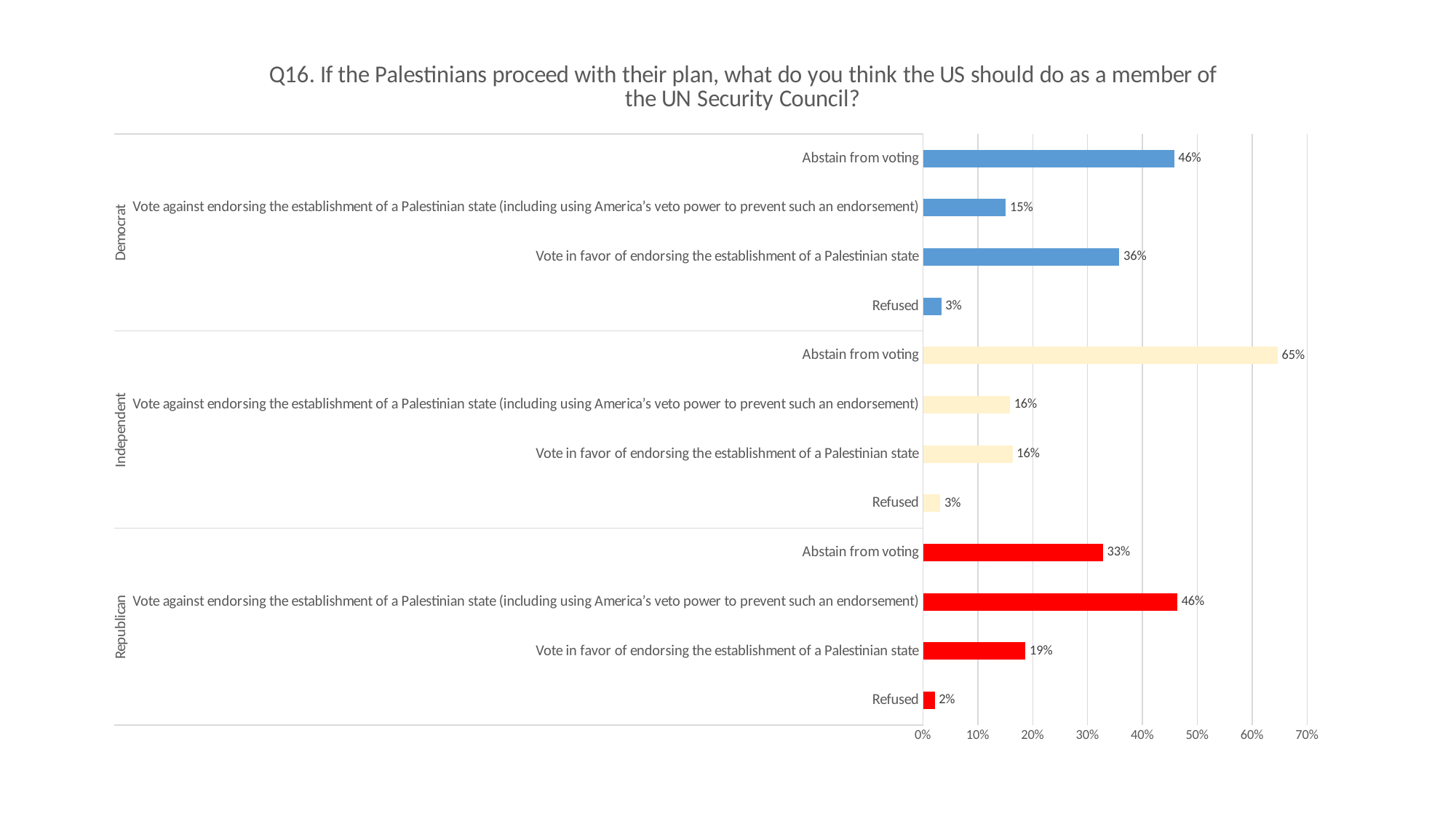
Which response has the lowest value among Democrats? Refused What type of chart is shown on the slide? Bar chart What percentage of Republicans say the US should vote against endorsing the establishment of a Palestinian state? 46% What is the difference between the Independent and Democrat percentages for 'Abstain from voting'? 19% What percentage of Republicans refused to answer? 2% Which is larger: the Democrat percentage for 'Vote in favor of endorsing the establishment of a Palestinian state' or the Republican percentage for the same response? Democrat What percentage of Democrats say the US should abstain from voting? 46% Is the Independent value for 'Abstain from voting' greater or less than 60%? greater What percentage of Independents say the US should abstain from voting? 65% What colour are the bars for the Republican group? Red How many party groups are shown on the chart? 3 Which response has the highest value among Republicans? Vote against endorsing the establishment of a Palestinian state (including using America's veto power to prevent such an endorsement)